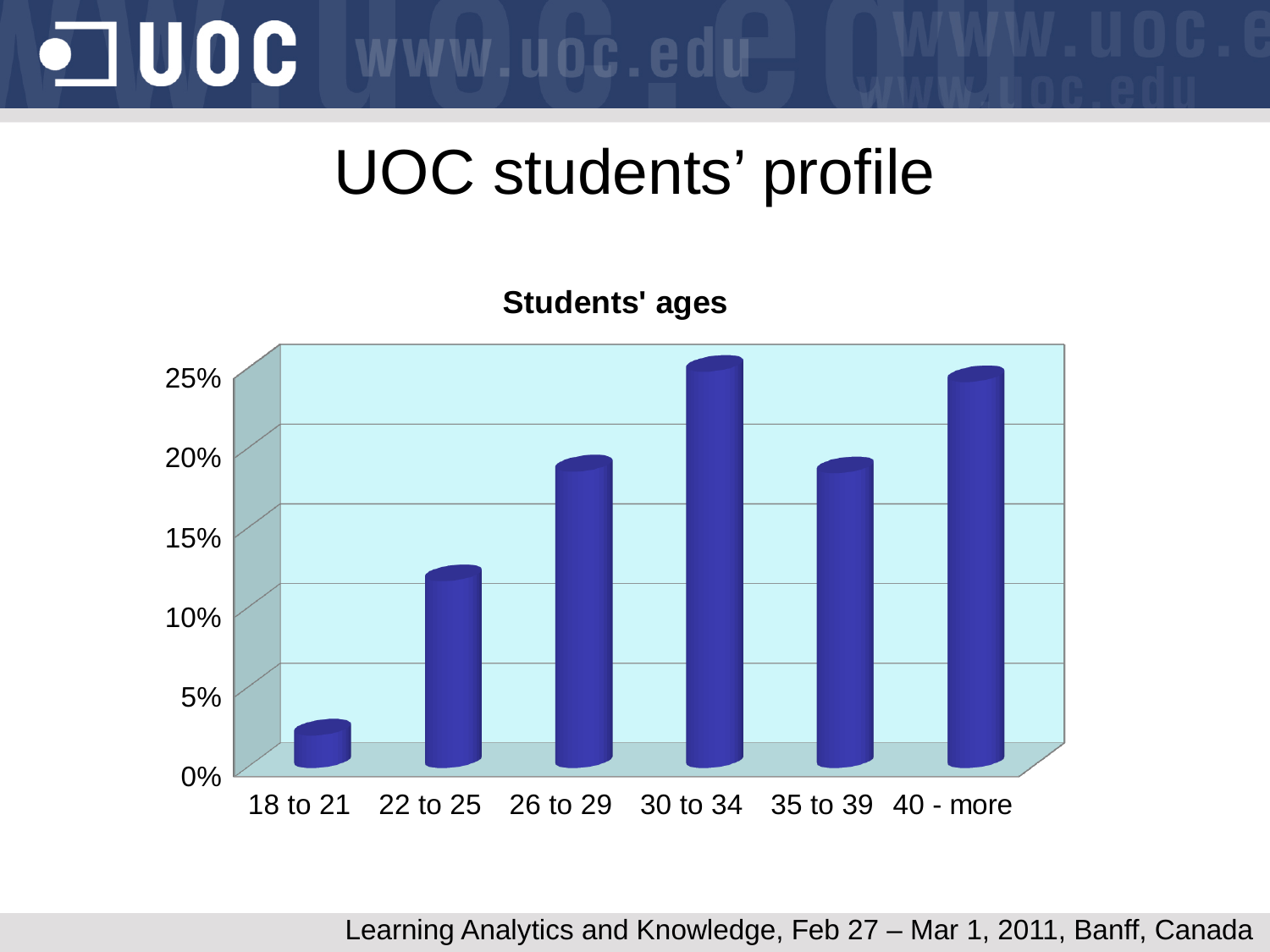
Is the value for 40 - more greater or less than 20%? greater Which has the larger value, 22 to 25 or 26 to 29? 26 to 29 What is the title of the chart? Students' ages Do the values rise or fall from the 18 to 21 category to the 30 to 34 category? rise Which age category has the lowest value in the chart? 18 to 21 How many age categories are shown on the x axis of the chart? 6 What kind of chart is shown on the slide? bar chart Is the value for 22 to 25 greater or less than 10%? greater Is the value for 30 to 34 greater or less than 20%? greater